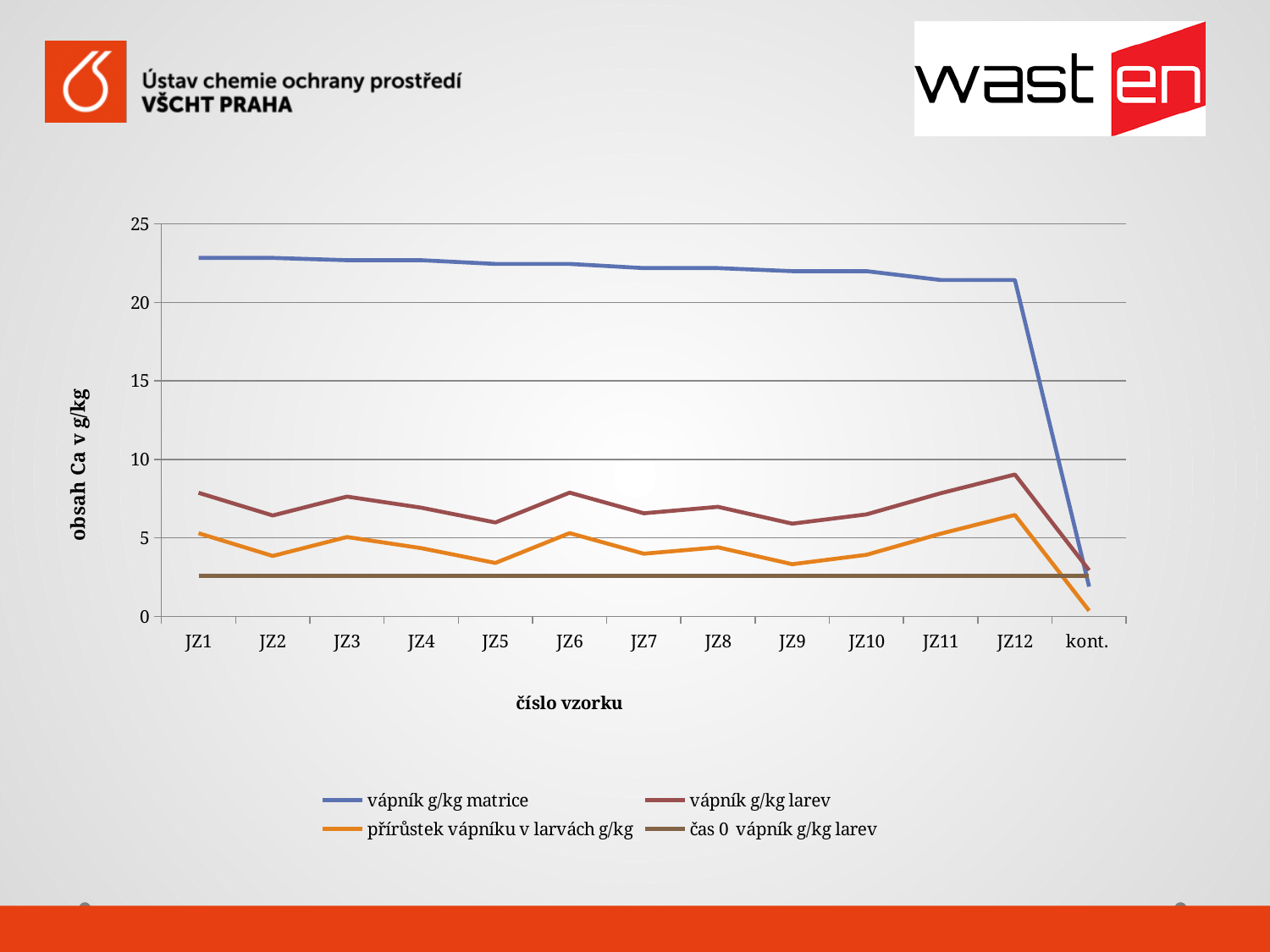
At which category does vápník g/kg larev reach its highest value? JZ12 What is the title of the y axis? obsah Ca v g/kg Is the value of přírůstek vápníku v larvách g/kg at JZ5 greater or less than 5? less Does the čas 0 vápník g/kg larev series rise, fall or stay flat across the x axis? stay flat How many series does the legend list? 4 What kind of chart is shown on the slide? line chart How many categories are shown on the x axis? 13 Is the value of vápník g/kg larev at JZ12 greater or less than 5? greater Is the value of vápník g/kg matrice at kont. greater or less than 5? less At which category does přírůstek vápníku v larvách g/kg reach its lowest value? kont. At JZ1, which is larger: vápník g/kg matrice or vápník g/kg larev? vápník g/kg matrice